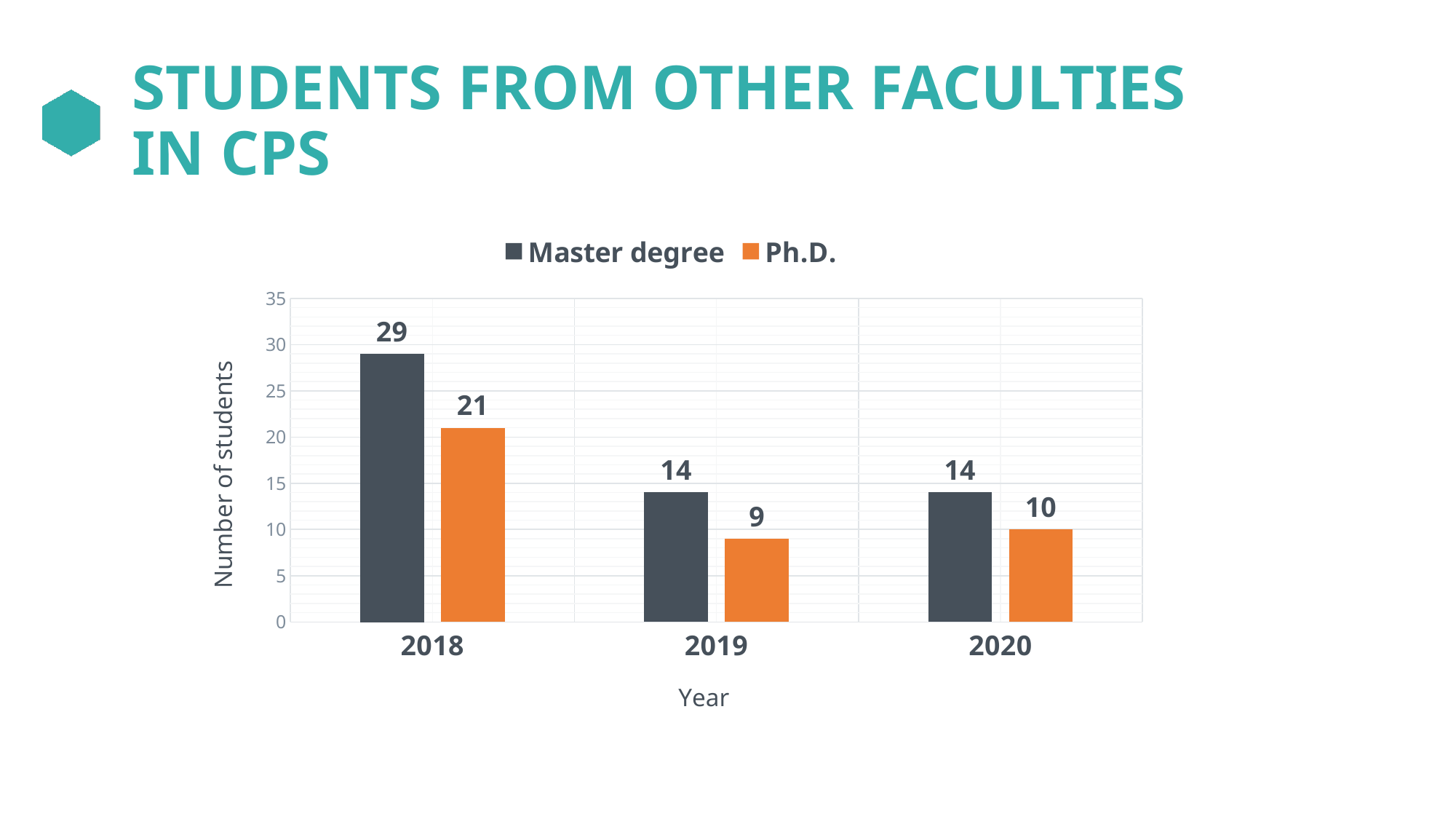
What is the number of Ph.D. students in 2020? 10 What is the number of Ph.D. students in 2019? 9 Which year has the highest number of Ph.D. students? 2018 What kind of chart is shown on the slide? Bar chart How many series does the legend list? 2 Is the value for Master degree in 2018 greater or less than 25? greater Which year has the lowest number of Ph.D. students? 2019 How many years are shown on the x axis? 3 What is the label of the y axis? Number of students Which is larger in 2020, the Master degree value or the Ph.D. value? Master degree What is the number of Master degree students in 2018? 29 What is the difference between Master degree and Ph.D. students in 2018? 8